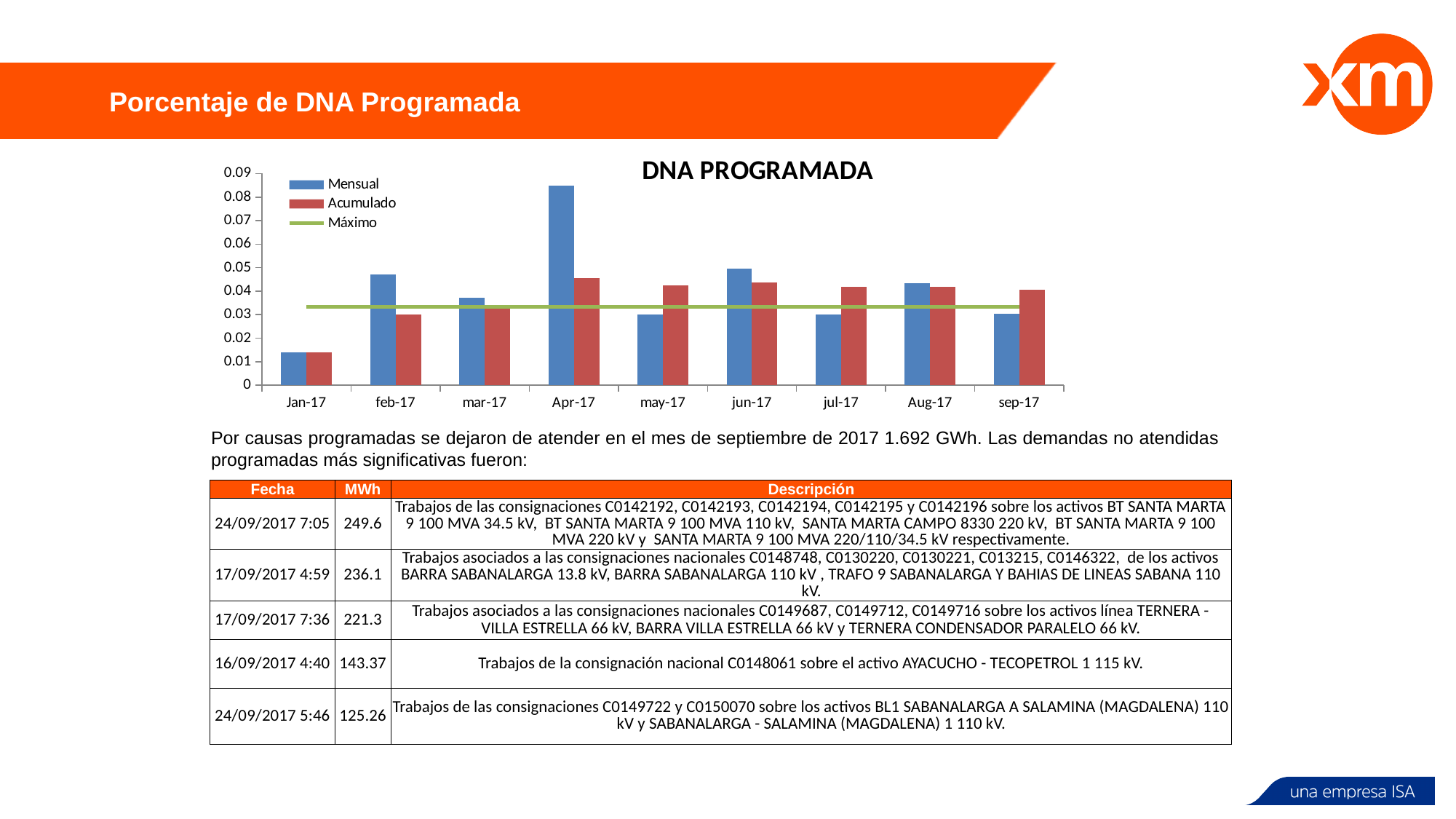
Is the Mensual value for Apr-17 greater or less than 0.08? greater Is the Acumulado value for jun-17 greater or less than 0.04? greater In the DNA PROGRAMADA chart, which is larger for feb-17: the Mensual value or the Acumulado value? Mensual What kind of chart is the DNA PROGRAMADA chart? bar chart In the DNA PROGRAMADA chart, which is larger for may-17: the Mensual value or the Acumulado value? Acumulado Is the Mensual value for Jan-17 greater or less than 0.02? less Which month has the highest Mensual value in the DNA PROGRAMADA chart? Apr-17 How many months are shown on the x axis of the DNA PROGRAMADA chart? 9 Which month has the lowest Acumulado value in the DNA PROGRAMADA chart? Jan-17 Which month has the lowest Mensual value in the DNA PROGRAMADA chart? Jan-17 What colour are the Acumulado bars in the DNA PROGRAMADA chart? red How many series does the legend of the DNA PROGRAMADA chart list? 3